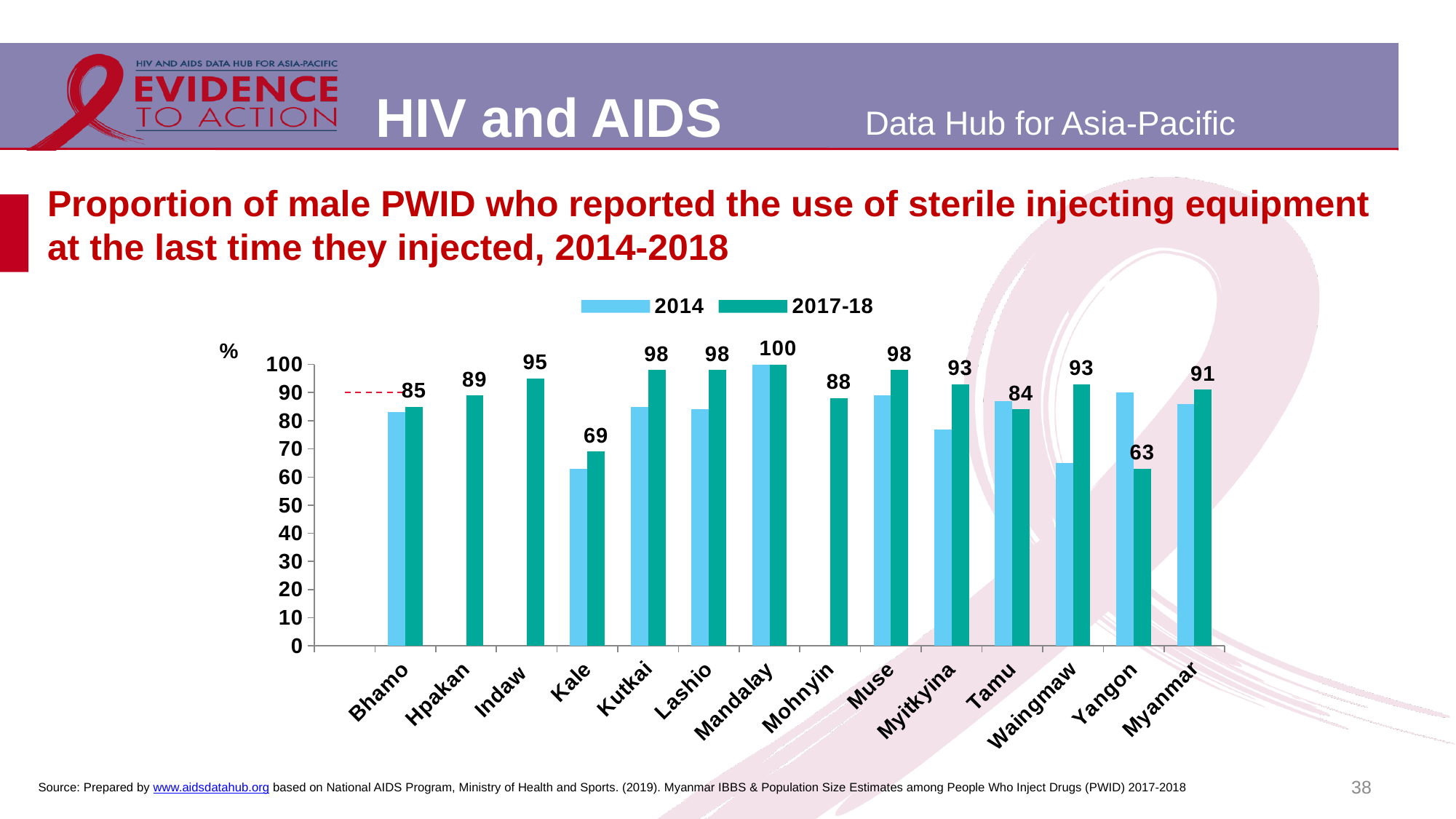
Is the 2014 value for Waingmaw greater or less than 70? less How many series does the legend list? 2 What is the 2017-18 value for Kale? 69 Is the 2014 value for Myitkyina greater or less than 80? less Which category has the lowest 2017-18 value? Yangon What kind of chart is shown on the slide? Bar chart Which has a larger 2017-18 value, Hpakan or Mohnyin? Hpakan What is the 2017-18 value for Mandalay? 100 What is the difference between the 2017-18 values for Indaw and Yangon? 32 What is the 2017-18 value for Myanmar? 91 How many categories are shown on the x axis? 14 Which category has the highest 2017-18 value? Mandalay